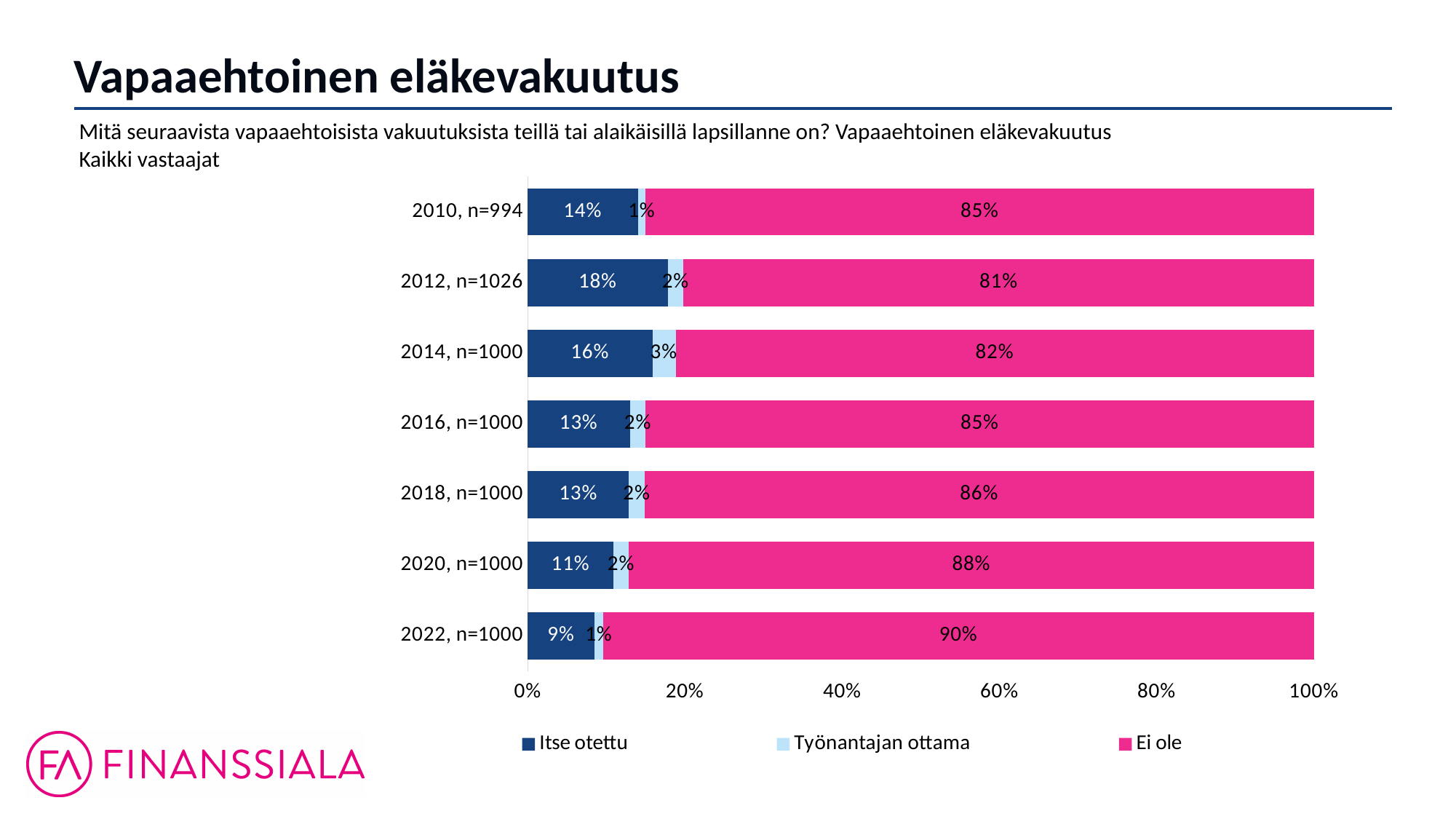
What is the value for "Itse otettu" in 2010, n=994? 14% Which year has the lowest value for "Ei ole"? 2012, n=1026 Is the value for "Ei ole" in 2018, n=1000 greater or less than 80%? greater How many series does the legend list? 3 What is the value for "Ei ole" in 2022, n=1000? 90% Which year has the highest value for "Itse otettu"? 2012, n=1026 Does the value for "Itse otettu" rise or fall from 2016 to 2022? Fall What kind of chart is shown on the slide? Stacked bar chart Which is larger: "Itse otettu" in 2014, n=1000 or in 2020, n=1000? 2014, n=1000 How many year categories are shown in the chart? 7 What is the difference between the "Ei ole" values for 2022, n=1000 and 2010, n=994? 5% What is the value for "Työnantajan ottama" in 2014, n=1000? 3%